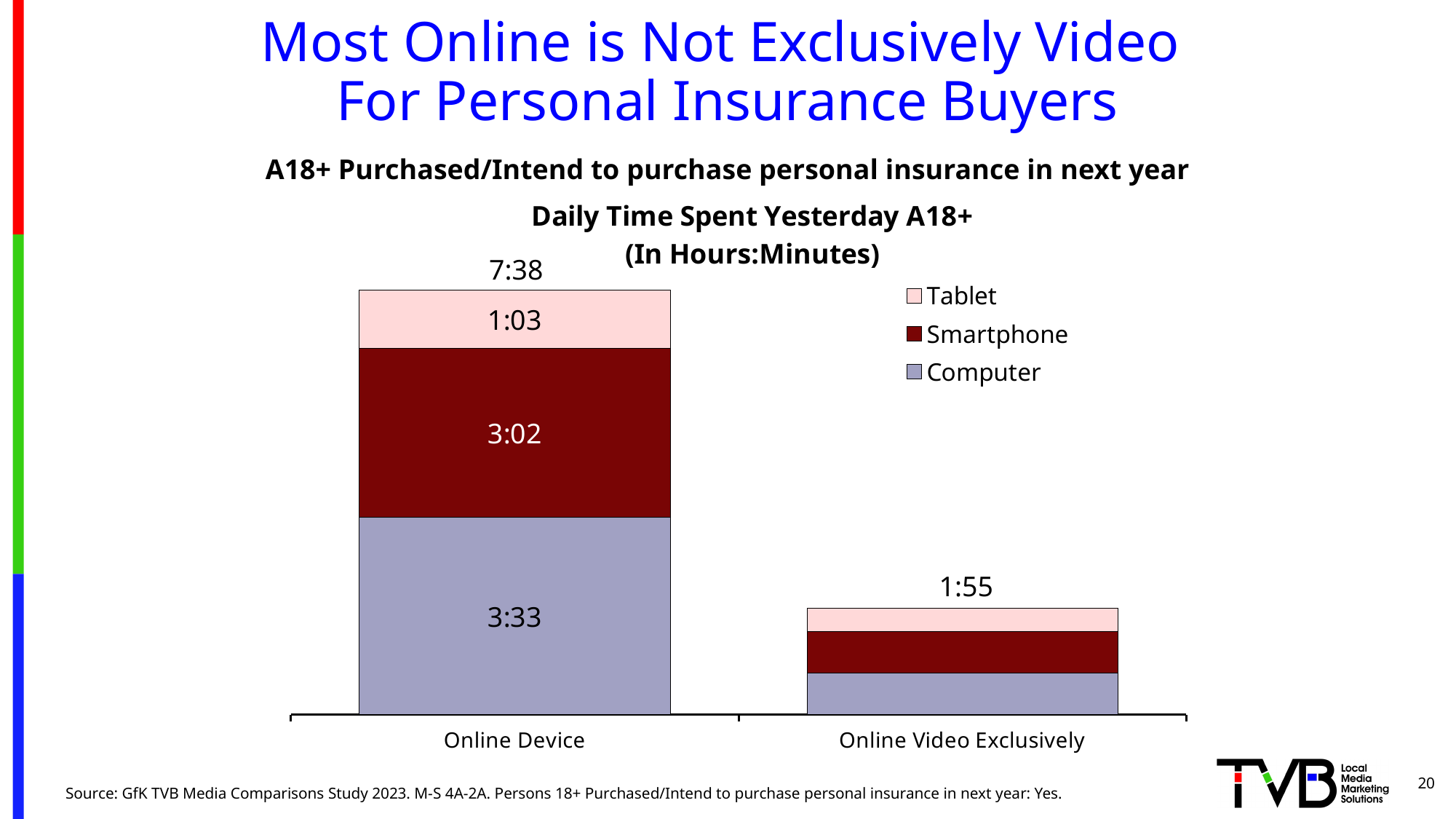
What is the Smartphone value for Online Device? 3:02 How many categories are shown on the x axis? 2 What is the total daily time spent for Online Video Exclusively? 1:55 How many series does the legend list? 3 What is the Tablet value for Online Device? 1:03 Which device segment is the largest in the Online Device bar? Computer What kind of chart is shown on the slide? Stacked bar chart Which device segment is the smallest in the Online Device bar? Tablet Which category has the larger total, Online Device or Online Video Exclusively? Online Device What is the total daily time spent for Online Device? 7:38 What is the Computer value for Online Device? 3:33 What is the difference between the Online Device total and the Online Video Exclusively total? 5:43